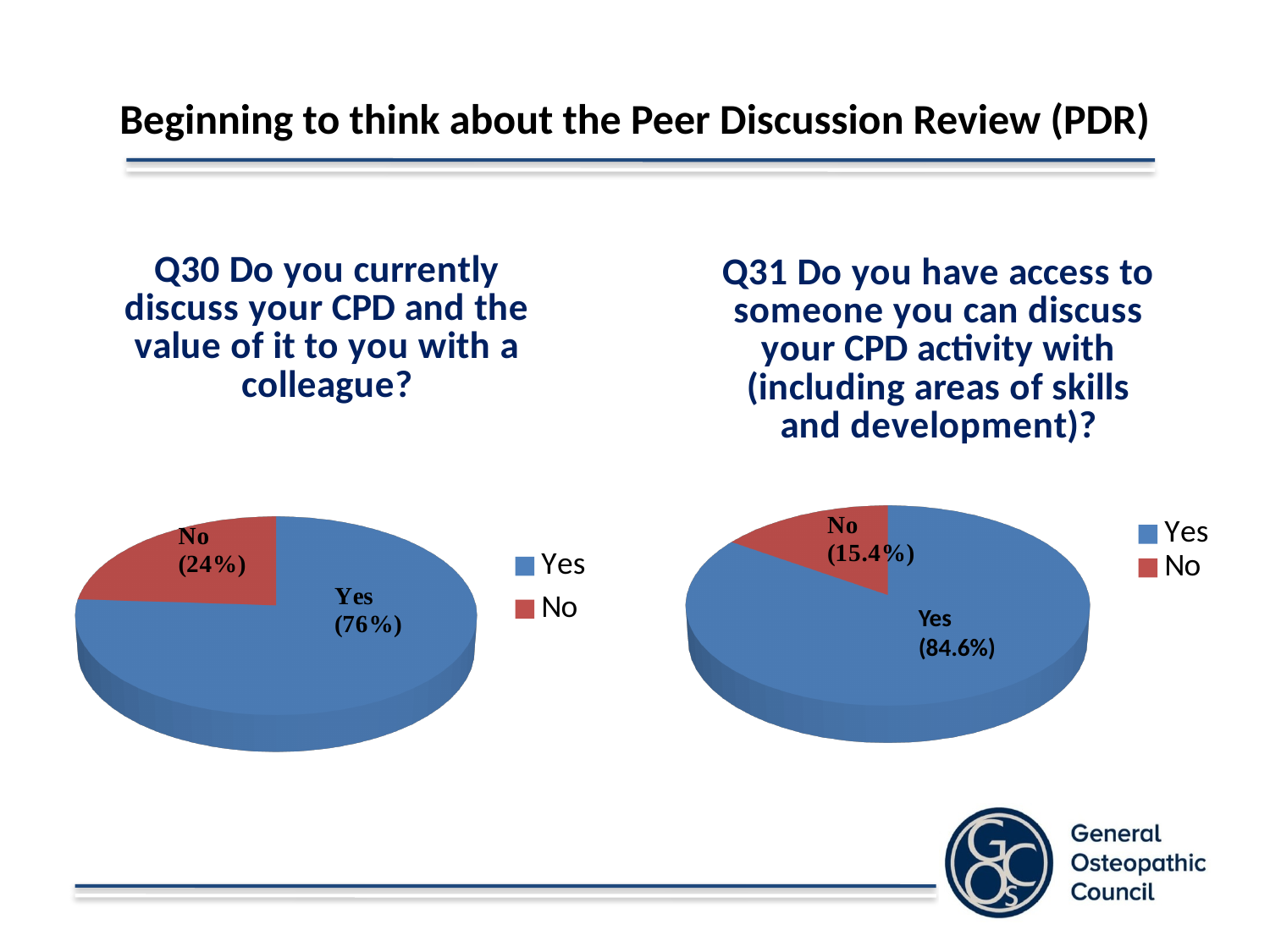
In the Q31 pie chart (right), what is the difference in percentage points between the Yes and No shares? 69.2 In the Q31 pie chart (right), what percentage of respondents answered Yes? 84.6% In the Q30 pie chart (left), what percentage of respondents answered Yes? 76% How many slices does the Q31 pie chart (right) have? 2 In the Q31 pie chart (right), what percentage of respondents answered No? 15.4% Which chart has the larger Yes share, the Q30 chart (left) or the Q31 chart (right)? Q31 chart (right) In the Q30 pie chart (left), what colour represents the No slice? Red What type of chart is used for Q30 on the left? Pie chart In the Q30 pie chart (left), what percentage of respondents answered No? 24% In the Q30 pie chart (left), which response has the largest share? Yes In the Q31 pie chart (right), which response has the smallest share? No In the Q30 pie chart (left), what is the difference in percentage points between the Yes and No shares? 52